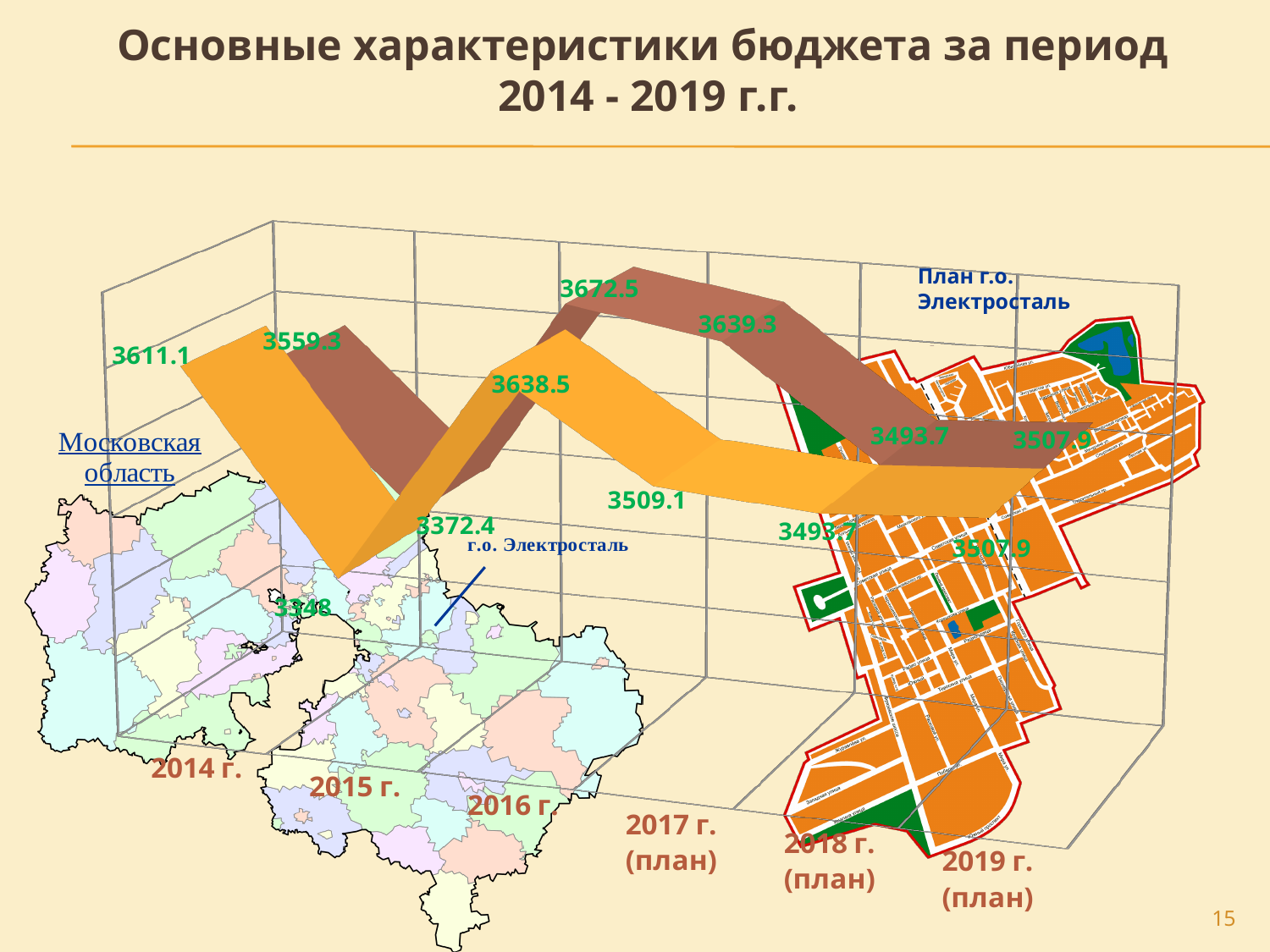
What value is labelled on the orange ribbon for 2015 г.? 3348 What is the title of the slide's chart? Основные характеристики бюджета за период 2014 - 2019 г.г. What value is labelled on the brown ribbon for 2016 г.? 3672.5 What is the difference between the orange ribbon's values for 2016 г. (3638.5) and 2015 г. (3348)? 290.5 How many year categories are plotted along the x axis of the chart? 6 In which year does the brown ribbon reach its highest labelled value? 2016 г. In which year does the orange ribbon reach its lowest labelled value? 2015 г. What kind of chart is shown on the slide? line chart What is the difference between the brown ribbon's values for 2016 г. (3672.5) and 2017 г. (план) (3639.3)? 33.2 What value is labelled for 2019 г. (план)? 3507.9 For 2014 г., which ribbon has the larger labelled value, the orange (3611.1) or the brown (3559.3)? orange Does the orange ribbon rise or fall from 2014 г. to 2015 г.? falls